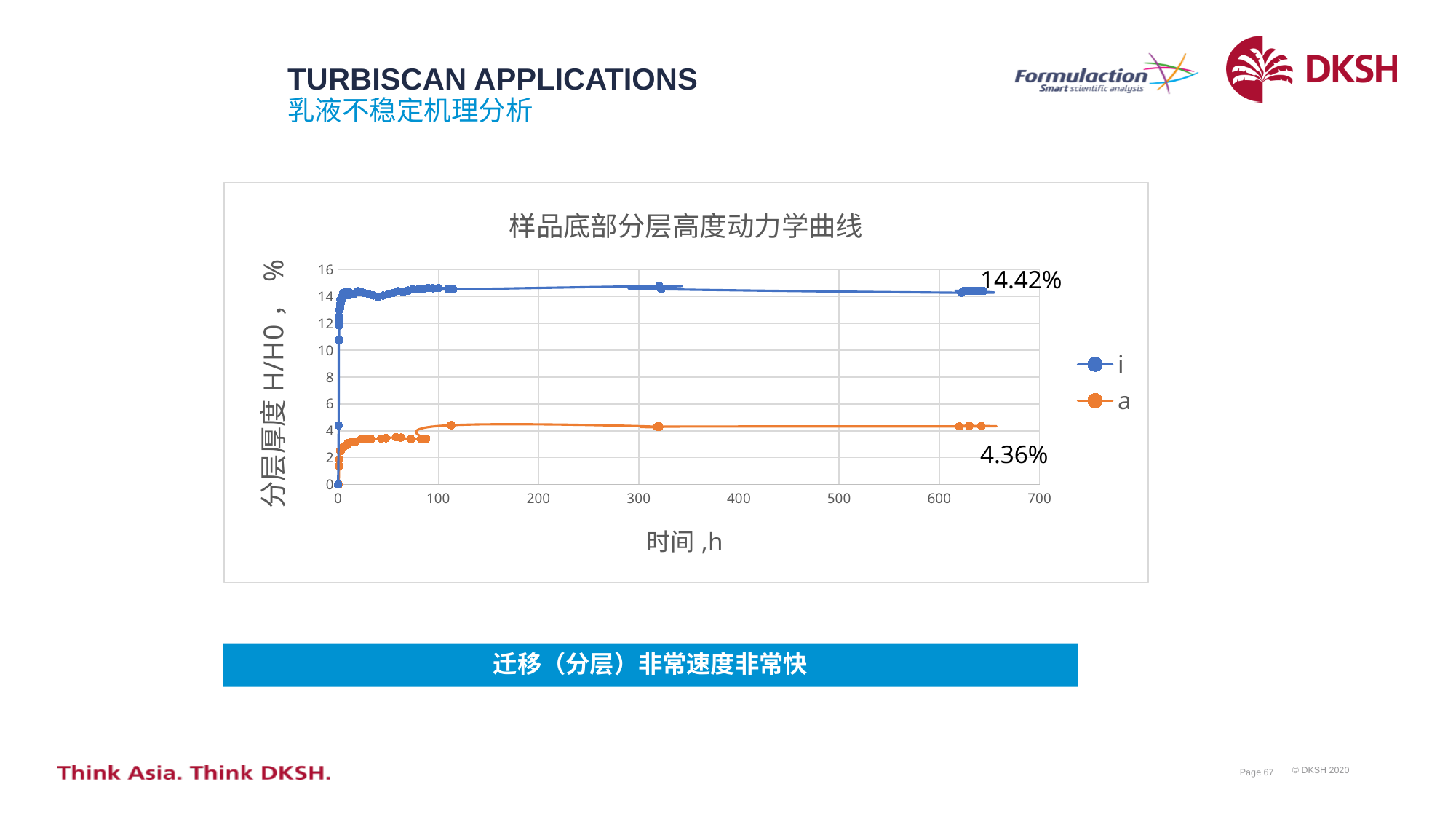
What are the names of the two series in the legend? i and a Is the value of series a at around 300 h greater or less than 6? less How many series does the legend list? 2 How does series i change along the x axis? rises sharply at the start, then stays roughly flat What is the title of the chart? 样品底部分层高度动力学曲线 What kind of chart is shown on the slide? line chart What value is labelled at the end of series a? 4.36% Which series reaches the higher value, i or a? i What value is labelled at the end of series i? 14.42% What is the difference between the labelled end values of series i (14.42%) and series a (4.36%)? 10.06% Is the value of series i at around 300 h greater or less than 12? greater What is the highest tick value shown on the x axis (时间, h)? 700